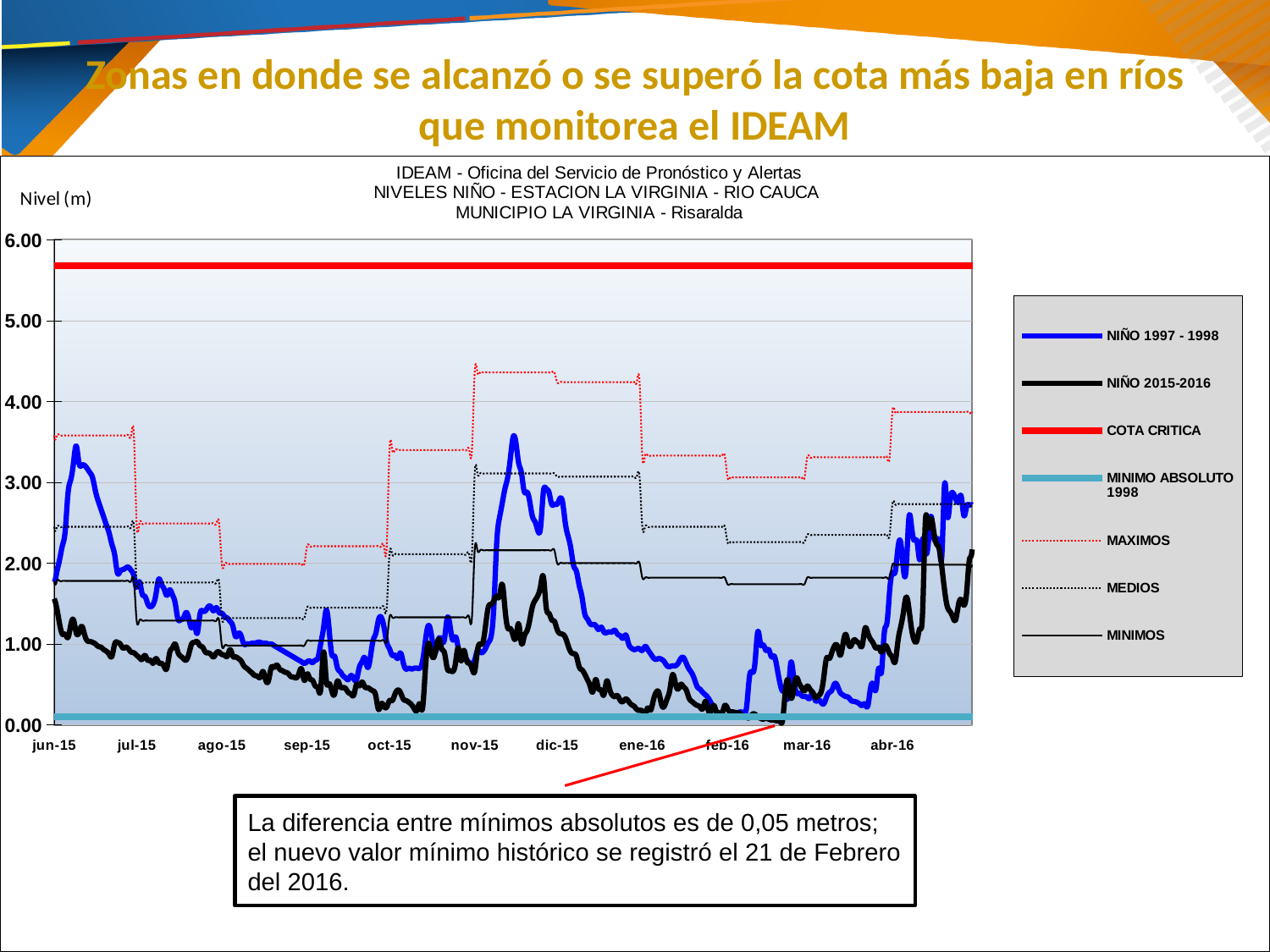
What kind of chart is shown on the slide? line chart Is the highest value of the MAXIMOS line (around nov-15 to dic-15) greater or less than 4.00? greater Does the NIÑO 2015-2016 line rise or fall from feb-16 to abr-16? rise Is the value of the MINIMO ABSOLUTO 1998 line greater or less than 1.00? less How many series does the legend of the chart list? 7 Which line is higher on the chart, COTA CRITICA or MINIMO ABSOLUTO 1998? COTA CRITICA Is the value of the COTA CRITICA line greater or less than 5.00? greater How many month labels are shown along the x axis of the chart? 11 Does the NIÑO 2015-2016 line rise or fall overall from jun-15 to feb-16? fall Which series has the highest values across the whole chart? COTA CRITICA What is the label of the y axis of the chart? Nivel (m)